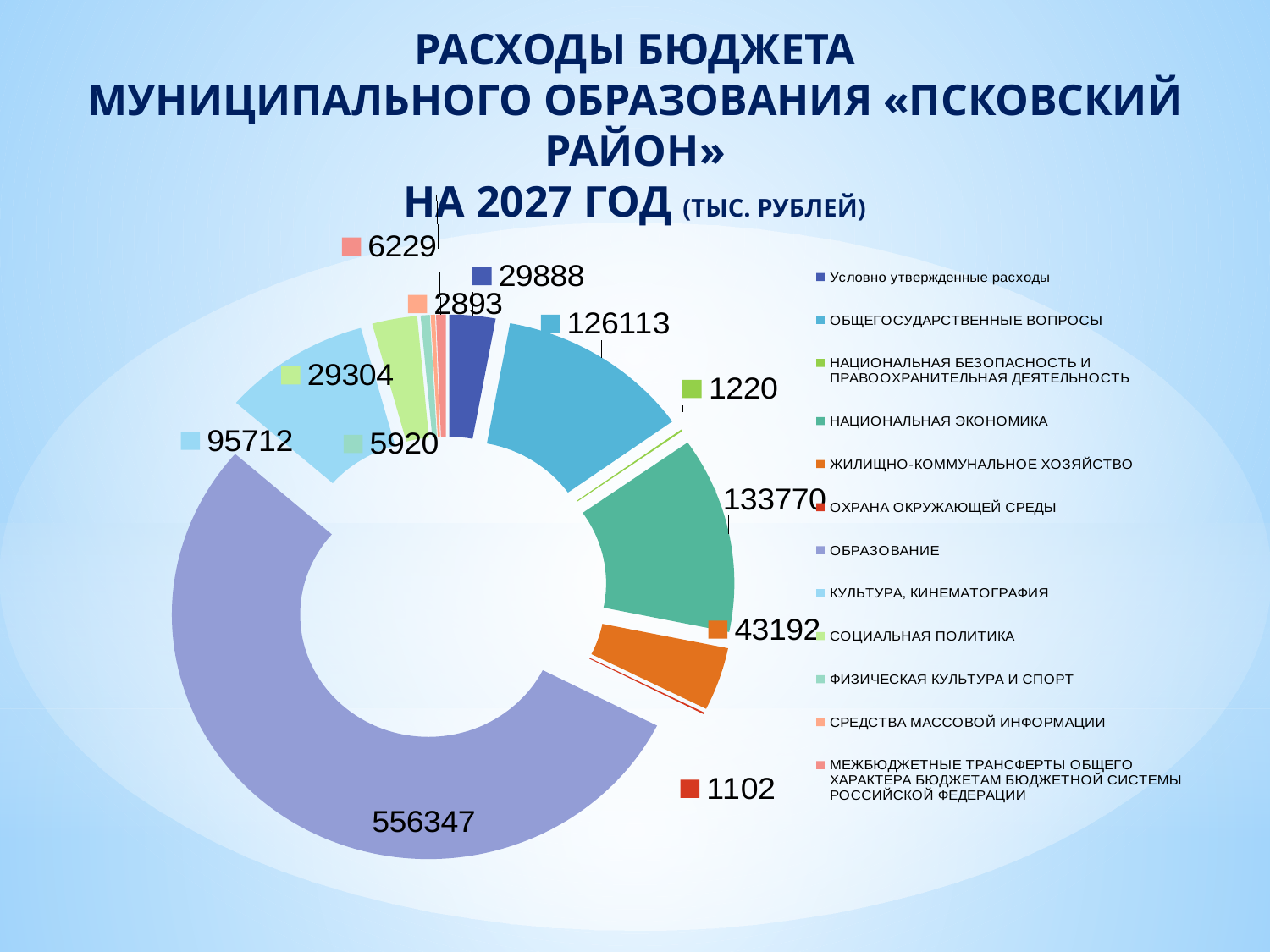
Which category has the smallest value? ОХРАНА ОКРУЖАЮЩЕЙ СРЕДЫ What is the value for КУЛЬТУРА, КИНЕМАТОГРАФИЯ? 95712 What is the value for СРЕДСТВА МАССОВОЙ ИНФОРМАЦИИ? 2893 What is the value for НАЦИОНАЛЬНАЯ ЭКОНОМИКА? 133770 Which is larger: the value for СОЦИАЛЬНАЯ ПОЛИТИКА or the value for Условно утвержденные расходы? Условно утвержденные расходы What is the difference between the values for НАЦИОНАЛЬНАЯ ЭКОНОМИКА and ОБЩЕГОСУДАРСТВЕННЫЕ ВОПРОСЫ? 7657 What is the value for ЖИЛИЩНО-КОММУНАЛЬНОЕ ХОЗЯЙСТВО? 43192 What type of chart is shown on the slide? doughnut (pie) chart Which category has the largest value? ОБРАЗОВАНИЕ What is the value for ОБРАЗОВАНИЕ? 556347 How many categories does the legend list? 12 In what units are the values on the chart expressed, according to the title? тыс. рублей